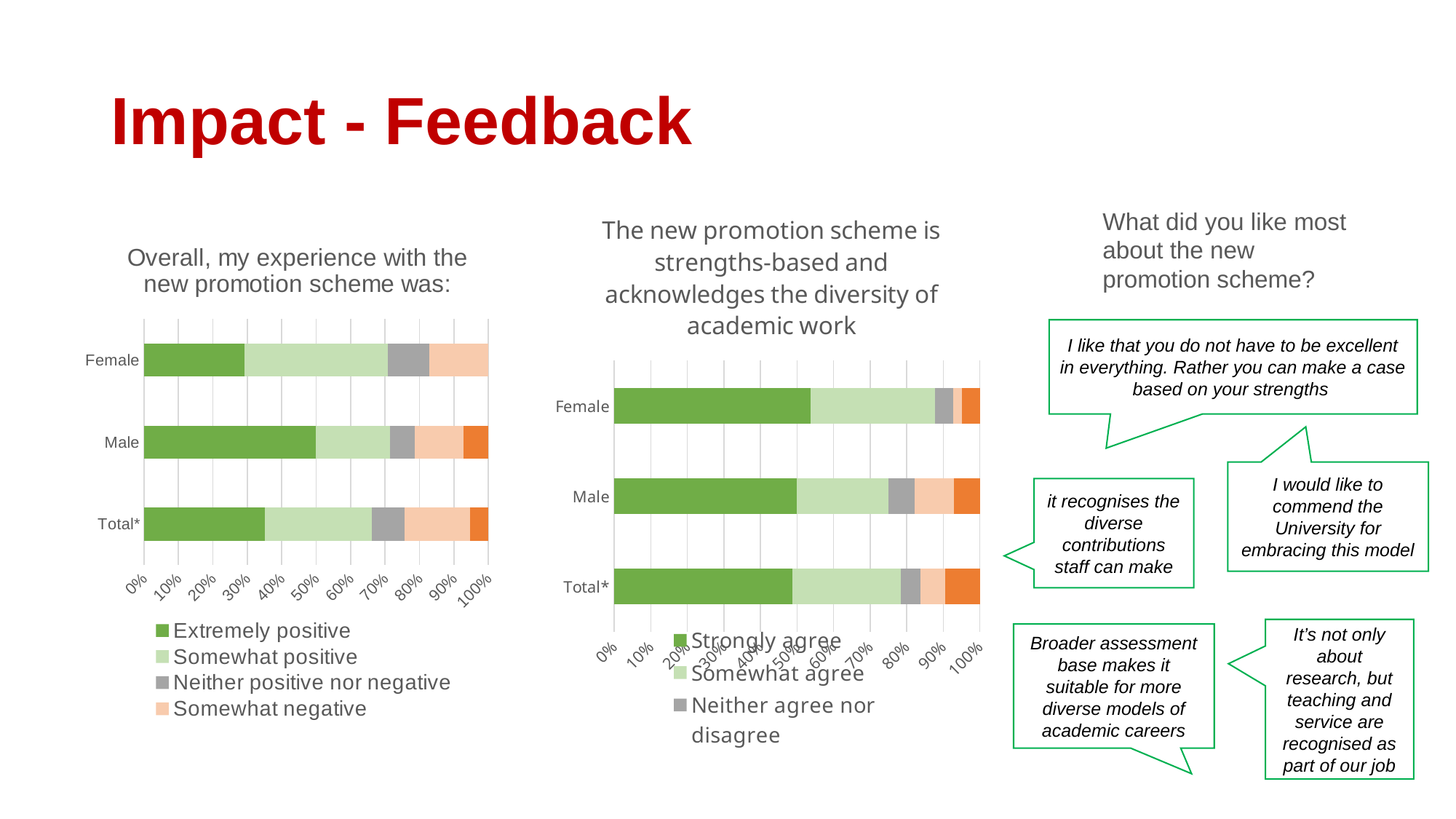
How many series does the legend list for the chart titled "Overall, my experience with the new promotion scheme was:"? 4 Which legend entry is shown in dark green in the chart titled "The new promotion scheme is strengths-based and acknowledges the diversity of academic work"? Strongly agree How many series does the legend list for the chart titled "The new promotion scheme is strengths-based and acknowledges the diversity of academic work"? 3 In the chart titled "Overall, my experience with the new promotion scheme was:", which category has the largest "Extremely positive" segment? Male In the chart titled "Overall, my experience with the new promotion scheme was:", is the "Extremely positive" value for Total* greater or less than 40%? less In the chart titled "Overall, my experience with the new promotion scheme was:", is the "Extremely positive" segment larger for Female or for Male? Male How many categories are shown on the y axis of the chart titled "Overall, my experience with the new promotion scheme was:"? 3 In the chart titled "The new promotion scheme is strengths-based and acknowledges the diversity of academic work", is the "Strongly agree" value for Female greater or less than 50%? greater In the chart titled "Overall, my experience with the new promotion scheme was:", is the "Extremely positive" value for Female greater or less than 40%? less What type of chart is the chart titled "Overall, my experience with the new promotion scheme was:"? Stacked bar chart What are the category labels on the y axis of the chart titled "The new promotion scheme is strengths-based and acknowledges the diversity of academic work"? Female, Male, Total*